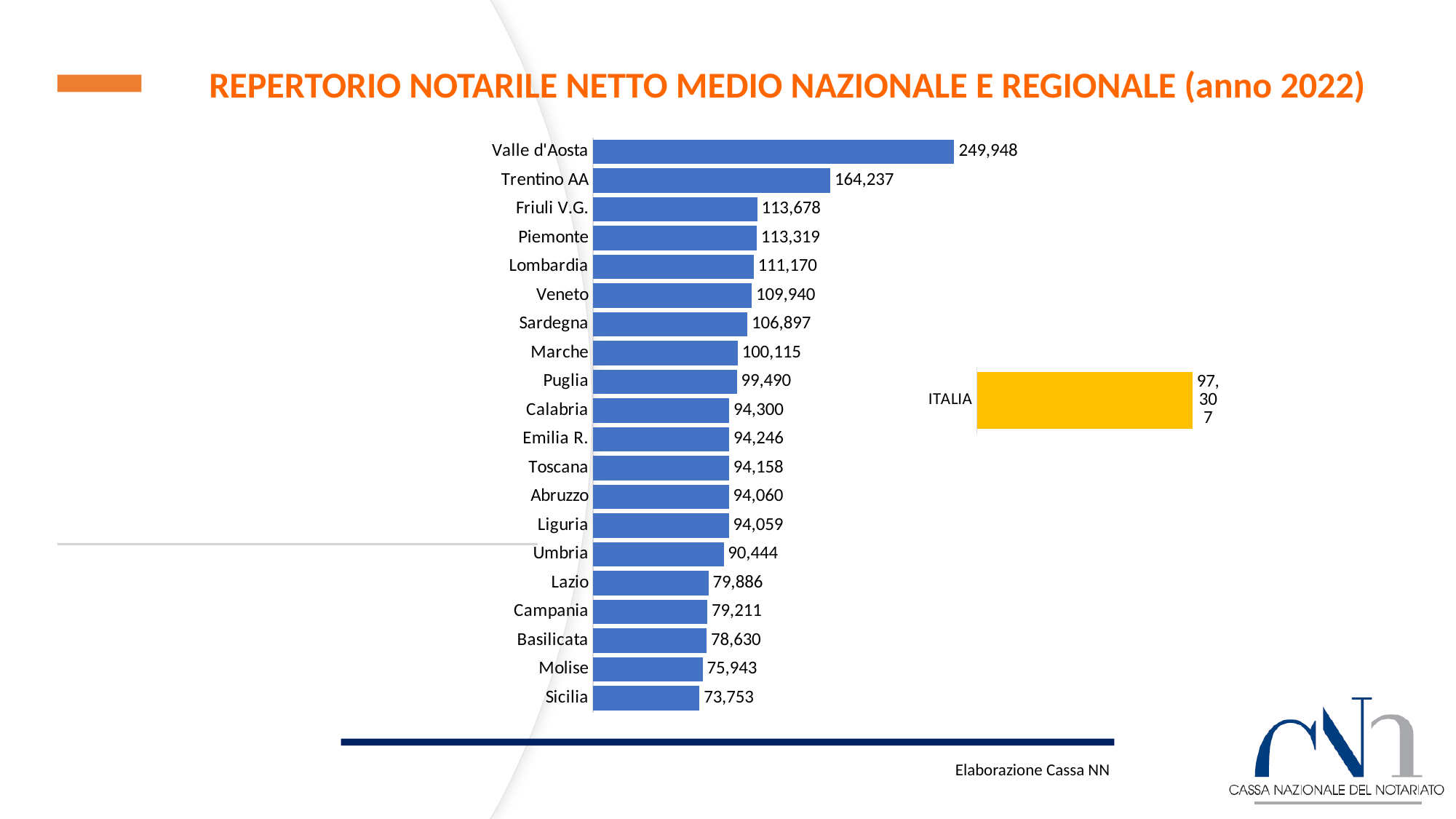
In the chart on the right, what is the value for ITALIA? 97,307 In the regional bar chart, which is larger, the value for Veneto or the value for Sardegna? Veneto In the regional bar chart, what is the value for Sicilia? 73,753 In the regional bar chart, which region has the highest value? Valle d'Aosta In the regional bar chart, what is the value for Marche? 100,115 What colour is the ITALIA bar in the chart on the right? Yellow In the regional bar chart, what is the difference between the values for Valle d'Aosta and Trentino AA? 85,711 How many regions are shown in the regional bar chart? 20 In the regional bar chart, what is the difference between the values for Lazio and Campania? 675 What kind of chart is used to show the regional values? Bar chart In the regional bar chart, what is the value for Lombardia? 111,170 In the regional bar chart, which region has the lowest value? Sicilia